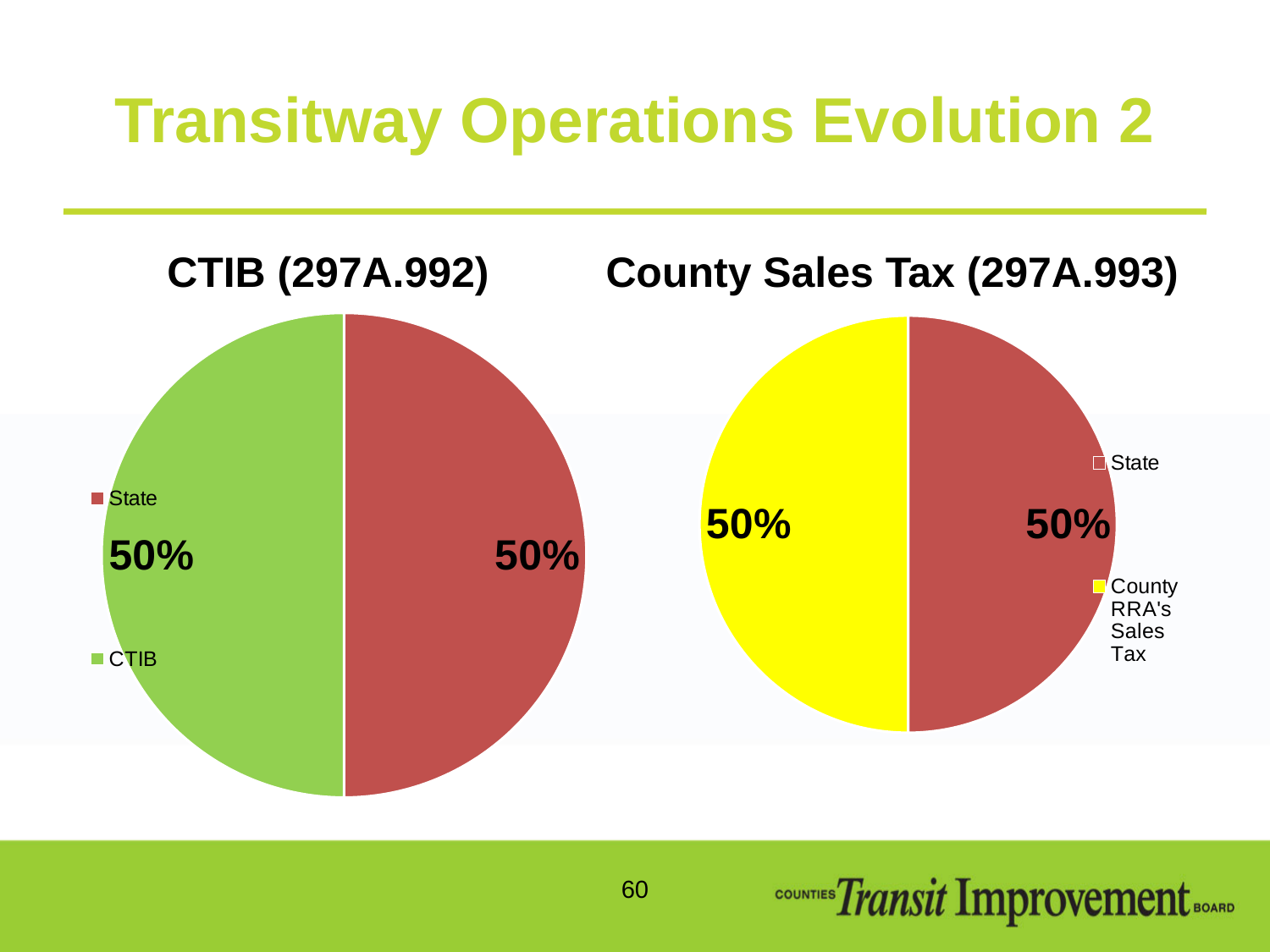
In the County Sales Tax (297A.993) chart, what share of the pie is State? 50% In the County Sales Tax (297A.993) chart, what share of the pie is County RRA's Sales Tax? 50% In the CTIB (297A.992) chart, what share of the pie is State? 50% How many entries does the legend of the County Sales Tax (297A.993) chart list? 2 What kind of chart is the CTIB (297A.992) chart? pie chart How many slices does the County Sales Tax (297A.993) pie chart have? 2 What kind of chart is the County Sales Tax (297A.993) chart? pie chart What is the title of the chart on the left side of the slide? CTIB (297A.992) In the CTIB (297A.992) chart, what is the difference between the State share and the CTIB share? 0% How many slices does the CTIB (297A.992) pie chart have? 2 In the County Sales Tax (297A.993) chart, what colour is the County RRA's Sales Tax slice? yellow